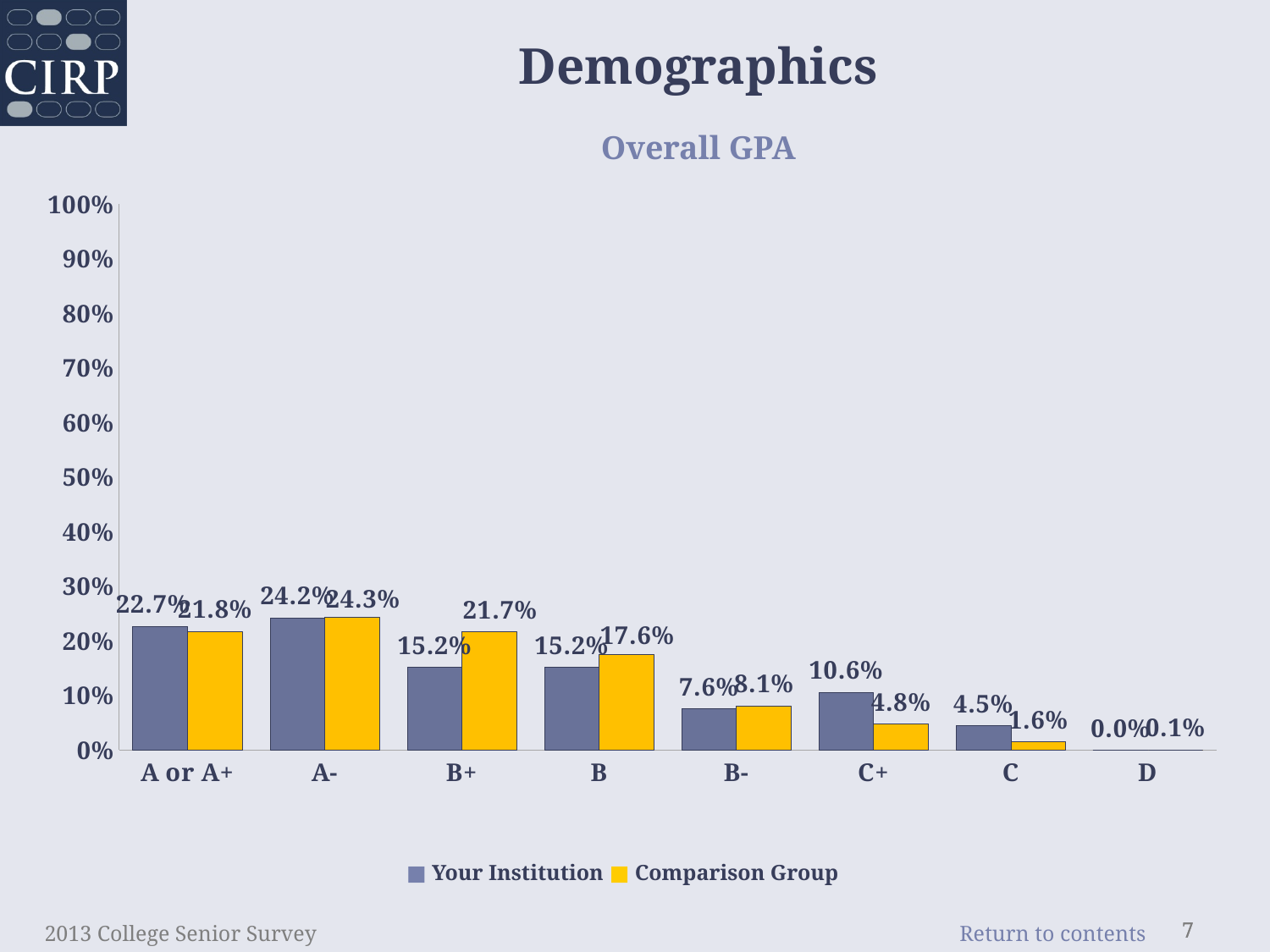
What is the value for Your Institution in the C+ category? 10.6% In the C+ category, which series has the larger value, Your Institution or Comparison Group? Your Institution Is the value for Your Institution in the A or A+ category greater or less than 20%? greater How many GPA categories are shown on the x axis? 8 What is the value for the Comparison Group in the B category? 17.6% What kind of chart is shown on the slide? bar chart What is the value for Your Institution in the A- category? 24.2% What is the difference between the Comparison Group and Your Institution values in the B+ category? 6.5% How many series does the legend list? 2 What is the title of the chart? Overall GPA Which GPA category has the highest value for Your Institution? A- Which GPA category has the lowest value for the Comparison Group? D